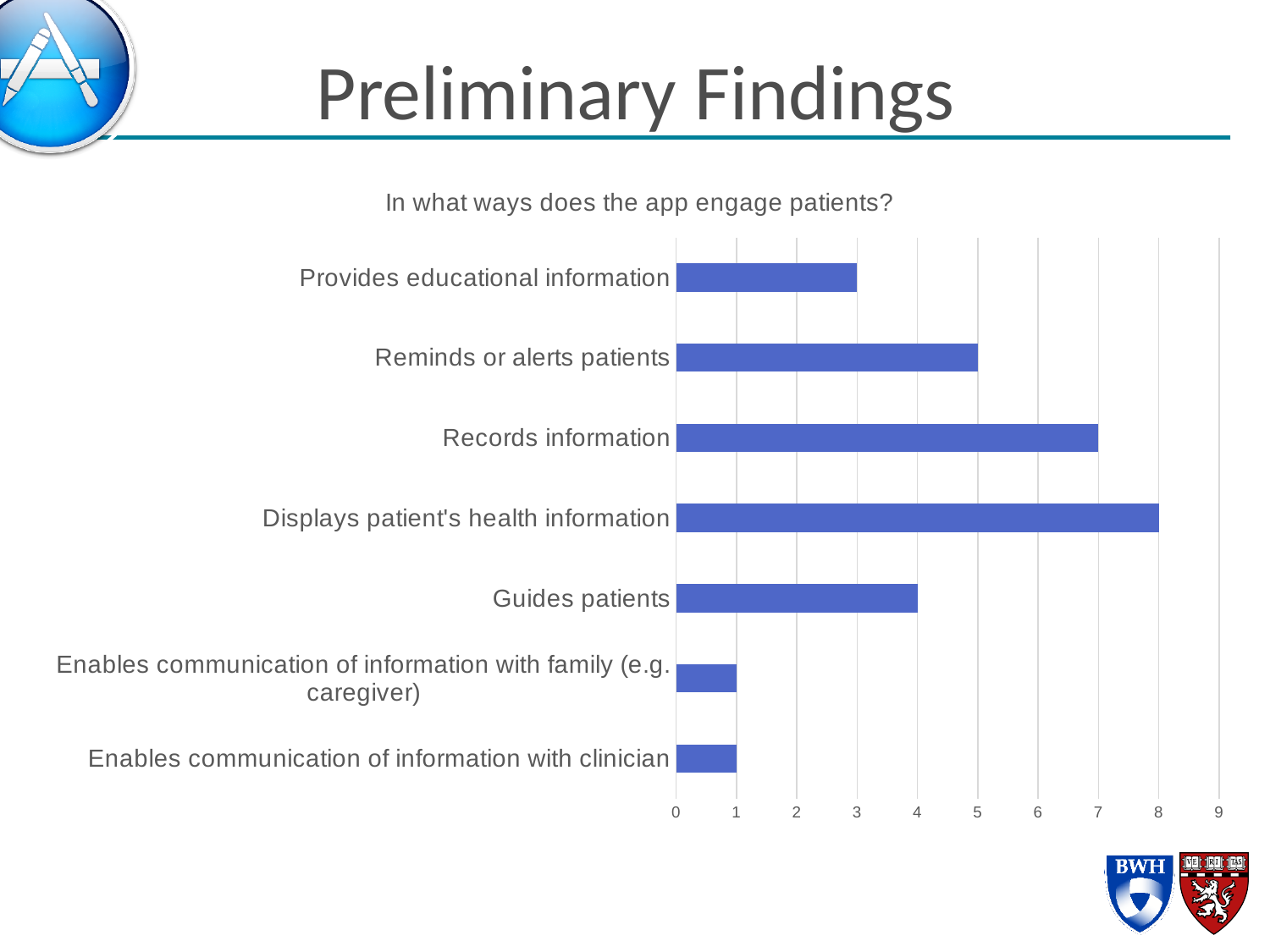
How many categories does the chart show? 7 What is the value for "Records information"? 7 Which category has the highest value? Displays patient's health information Which is larger, the value for "Reminds or alerts patients" or the value for "Guides patients"? Reminds or alerts patients Is the value for "Records information" greater or less than 5? greater What is the value for "Provides educational information"? 3 What kind of chart is shown on the slide? Bar chart What is the difference between the values for "Records information" and "Provides educational information"? 4 What is the value for "Reminds or alerts patients"? 5 What is the value for "Displays patient's health information"? 8 What is the title of the chart? In what ways does the app engage patients? What is the value for "Guides patients"? 4